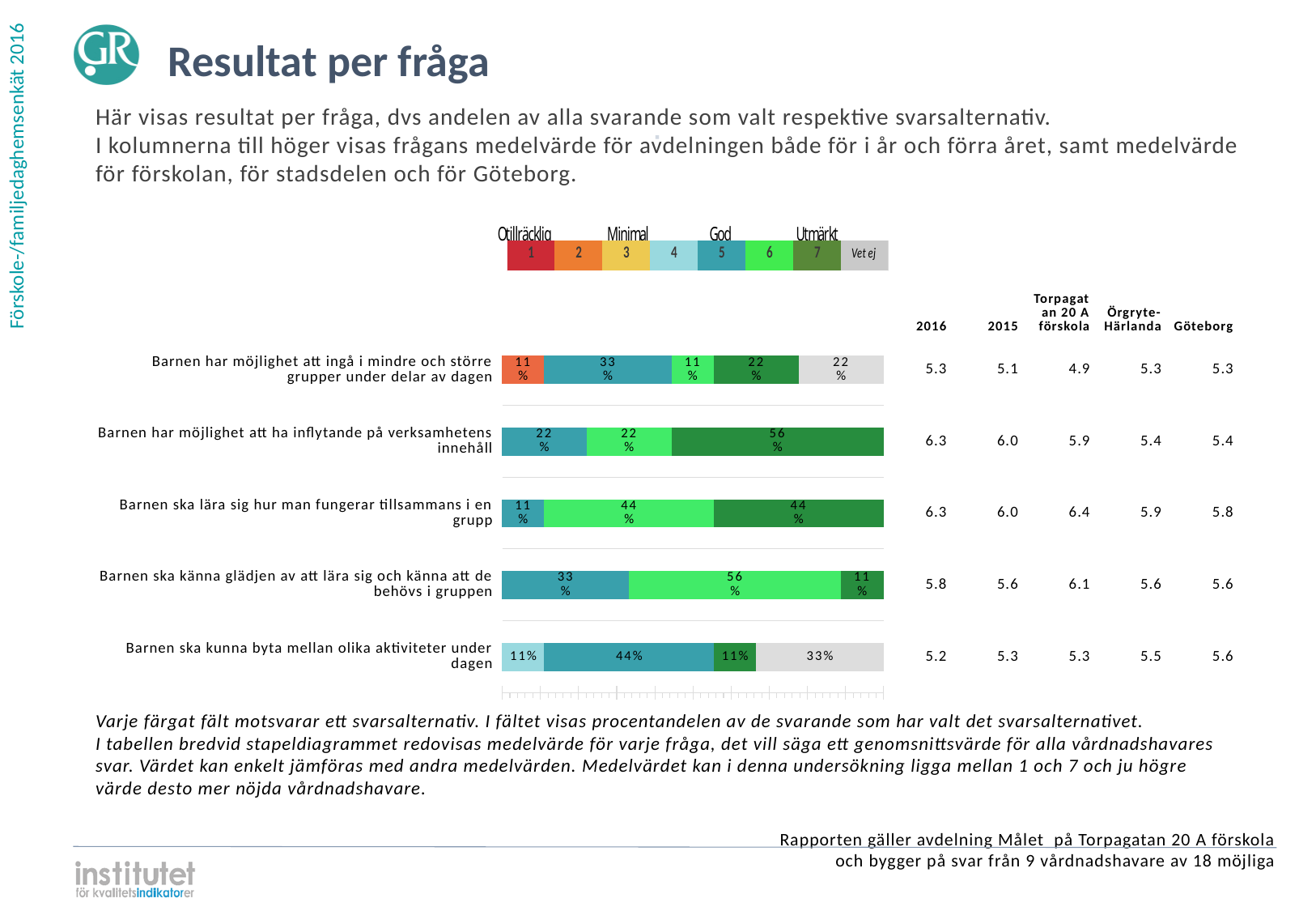
What colour represents the 'Vet ej' answer alternative in the chart? Grey What percentage of respondents chose 'Vet ej' for 'Barnen ska kunna byta mellan olika aktiviteter under dagen'? 33% What percentage chose answer 5 for 'Barnen ska kunna byta mellan olika aktiviteter under dagen'? 44% What kind of chart is shown on the slide? Stacked bar chart What is the difference between the share of answer 6 and the share of answer 5 for 'Barnen ska lära sig hur man fungerar tillsammans i en grupp'? 33 percentage points How many answer alternatives does the legend above the chart list? 8 For 'Barnen har möjlighet att ingå i mindre och större grupper under delar av dagen', which is larger: the share of answer 5 or the share of answer 7? Answer 5 (33%) What is the combined share of answers 6 and 7 for 'Barnen ska lära sig hur man fungerar tillsammans i en grupp'? 88% What percentage chose answer 7 (Utmärkt) for 'Barnen har möjlighet att ha inflytande på verksamhetens innehåll'? 56% What percentage chose answer 6 for 'Barnen ska känna glädjen av att lära sig och känna att de behövs i gruppen'? 56% Which question has the largest share of answer 7 (Utmärkt)? Barnen har möjlighet att ha inflytande på verksamhetens innehåll How many questions (categories) are plotted in the bar chart? 5